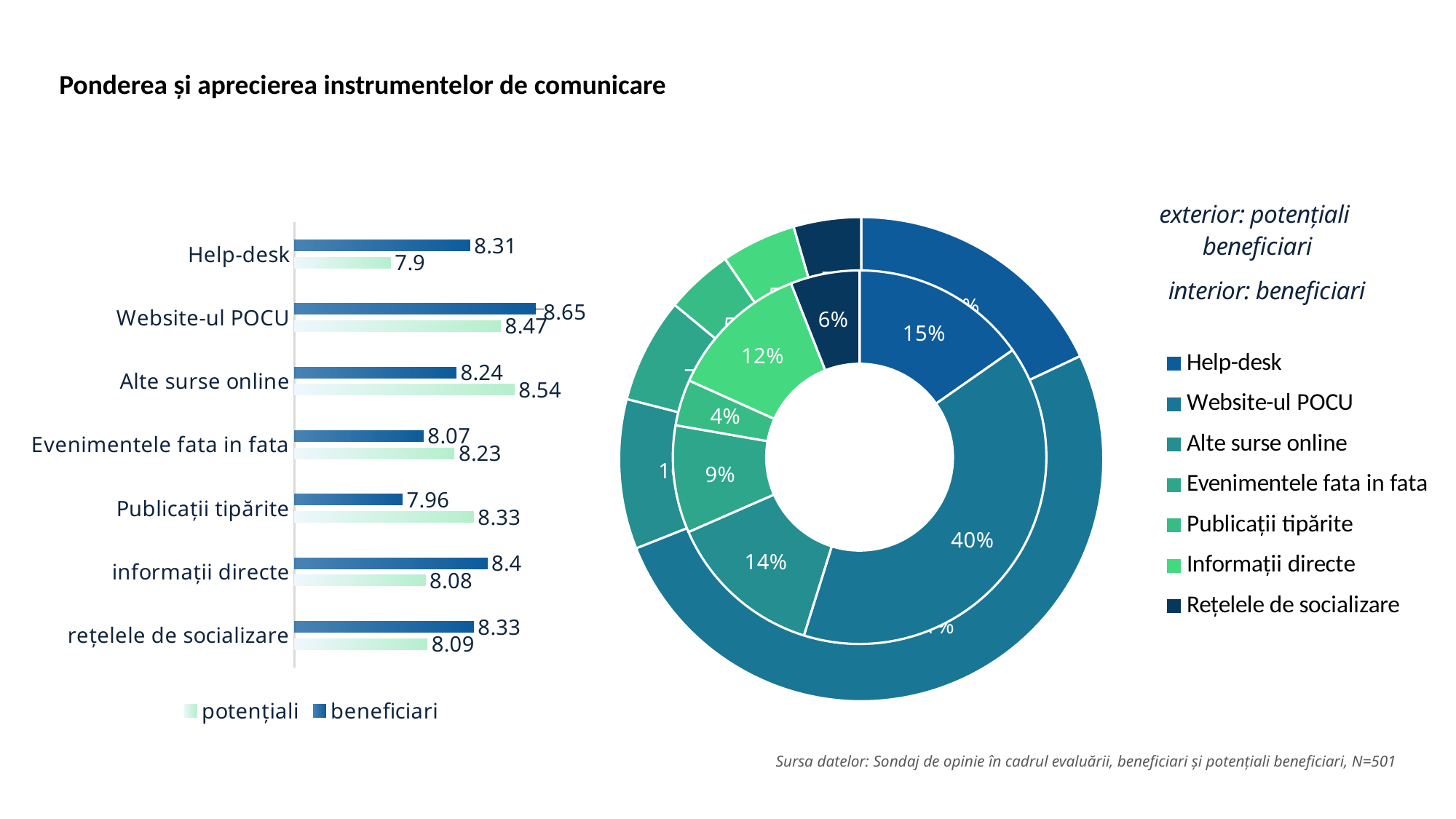
On the left bar chart, which category has the highest beneficiari value? Website-ul POCU On the left bar chart, which category has the lowest beneficiari value? Publicații tipărite What kind of chart is the chart on the left of the slide? bar chart On the left bar chart, what is the difference between the beneficiari and potențiali values for Help-desk? 0.41 On the left bar chart, what is the potențiali value for Publicații tipărite? 8.33 On the left bar chart, what is the potențiali value for Help-desk? 7.9 How many series does the legend of the left bar chart list? 2 How many categories does the left bar chart show? 7 On the left bar chart, which is larger for Alte surse online: the beneficiari value or the potențiali value? potențiali On the left bar chart, what is the beneficiari value for Website-ul POCU? 8.65 On the right doughnut chart, what share of the inner ring (beneficiari) is Website-ul POCU? 40% On the right doughnut chart, what share of the inner ring (beneficiari) is Rețelele de socializare? 6%